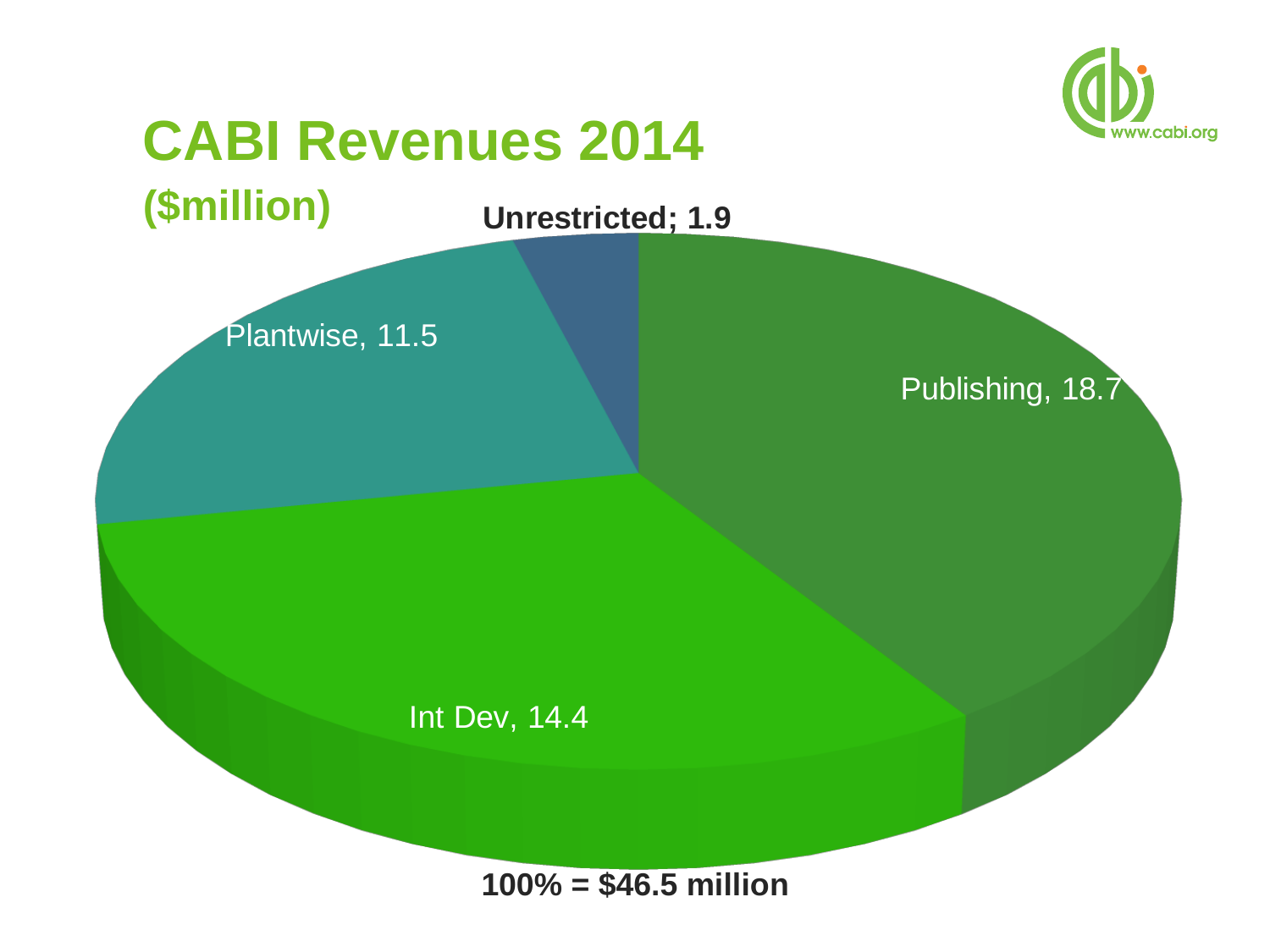
What total revenue does the slide state corresponds to 100% of the pie? $46.5 million Which category has the smallest slice in the pie chart? Unrestricted How many categories are shown in the pie chart? 4 What kind of chart is shown on the slide? Pie chart What is the difference between the Int Dev and Plantwise values? 2.9 What is the value for Int Dev in the pie chart? 14.4 What is the value for Publishing in the CABI Revenues 2014 pie chart? 18.7 Which is larger, Plantwise or Int Dev? Int Dev What is the difference between the Publishing and Int Dev values? 4.3 What is the value for Unrestricted in the pie chart? 1.9 What is the value for Plantwise in the pie chart? 11.5 Which category has the largest slice in the pie chart? Publishing